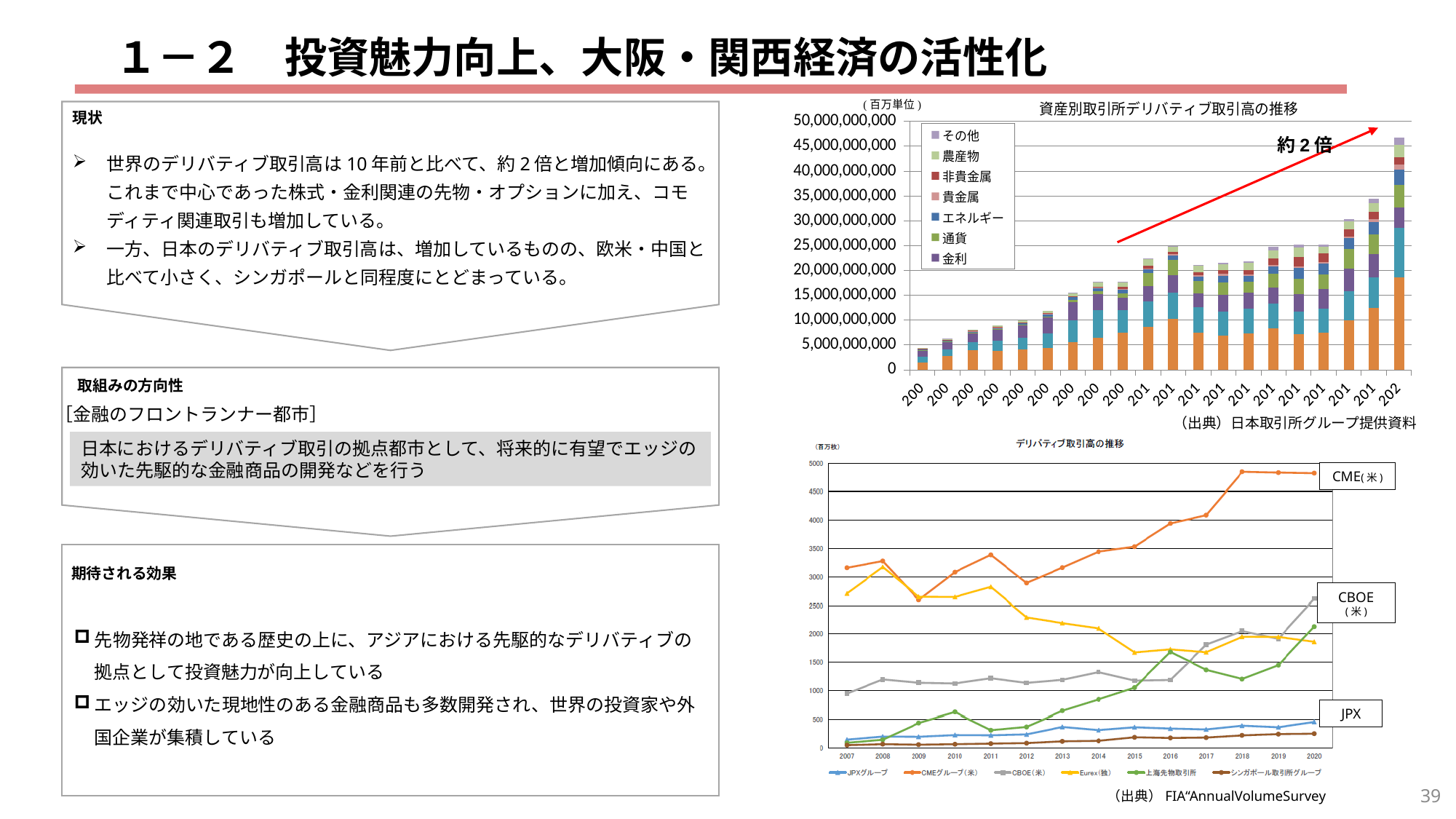
In the bottom-right chart デリバティブ取引高の推移, how many years are shown on the x axis? 14 What kind of chart is the top-right chart titled 資産別取引所デリバティブ取引高の推移? bar chart In the top-right chart 資産別取引所デリバティブ取引高の推移, do the total bar heights generally rise or fall from left to right? rise In the top-right chart 資産別取引所デリバティブ取引高の推移, is the total of the leftmost bar greater or less than 5,000,000,000? less In the bottom-right chart デリバティブ取引高の推移, is the value for CMEグループ(米) in 2020 greater or less than 4500? greater In the top-right chart 資産別取引所デリバティブ取引高の推移, is the total of the rightmost bar greater or less than 40,000,000,000? greater In the bottom-right chart デリバティブ取引高の推移, which series has the highest value in 2020? CMEグループ(米) What kind of chart is the bottom-right chart titled デリバティブ取引高の推移? line chart In the top-right chart 資産別取引所デリバティブ取引高の推移, how many entries does the legend list? 7 In the bottom-right chart デリバティブ取引高の推移, which is larger in 2020: CMEグループ(米) or CBOE(米)? CMEグループ(米) In the bottom-right chart デリバティブ取引高の推移, how many series does the legend list? 6 What unit is shown above the y axis of the top-right chart 資産別取引所デリバティブ取引高の推移? 百万単位